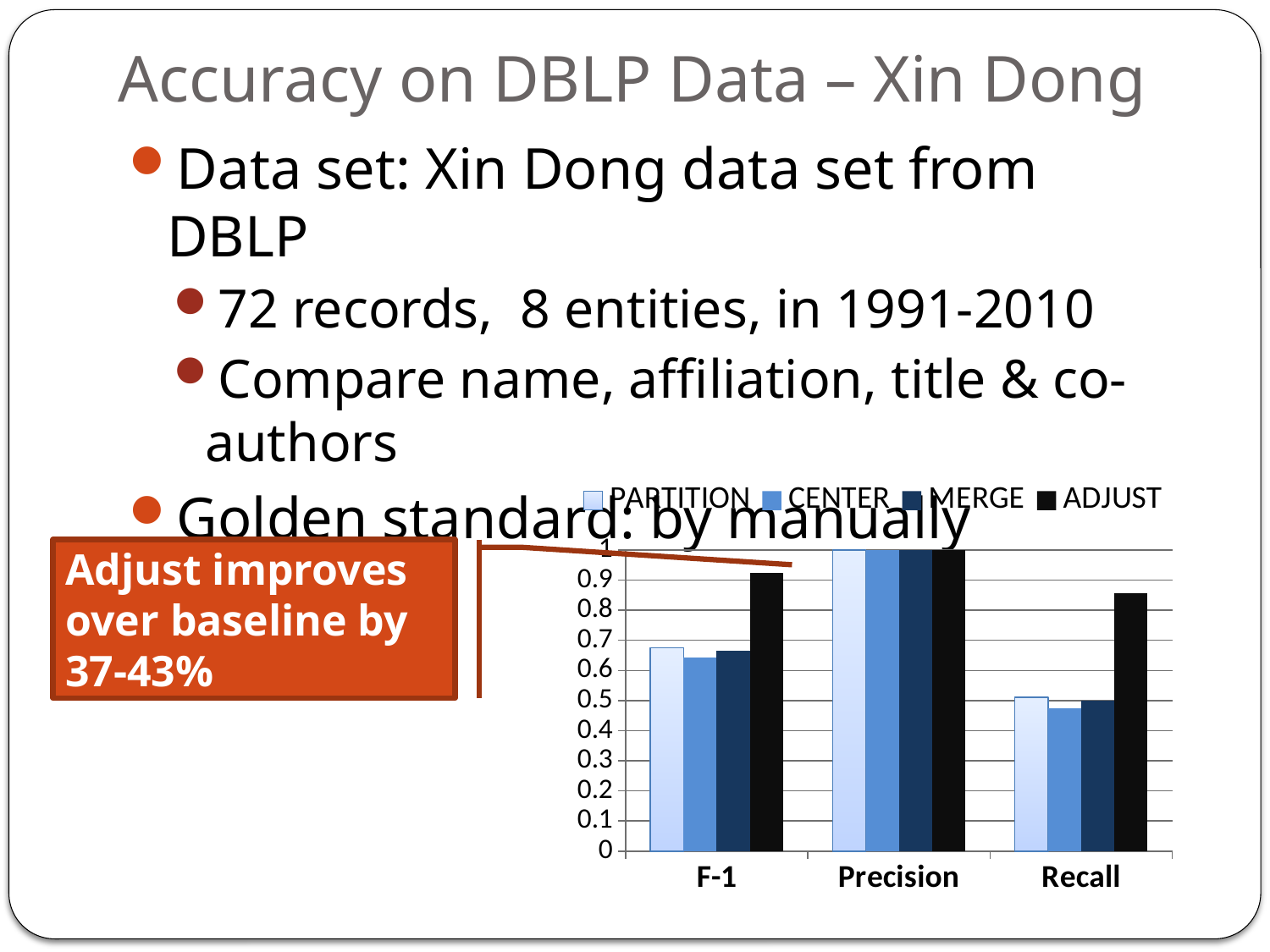
Which series is shown in black in the chart? ADJUST Is the value of CENTER for F-1 greater or less than 0.7? less Is the value of ADJUST for F-1 greater or less than 0.8? greater Is the value of PARTITION for F-1 greater or less than 0.6? greater How many series does the chart's legend list? 4 What kind of chart is shown on the slide? bar chart What are the three categories on the x axis of the chart? F-1, Precision, Recall How many categories are shown on the x axis of the chart? 3 Which series has the highest value for F-1? ADJUST Which series has the highest value for Recall? ADJUST Which is larger for the ADJUST series: the F-1 value or the Recall value? F-1